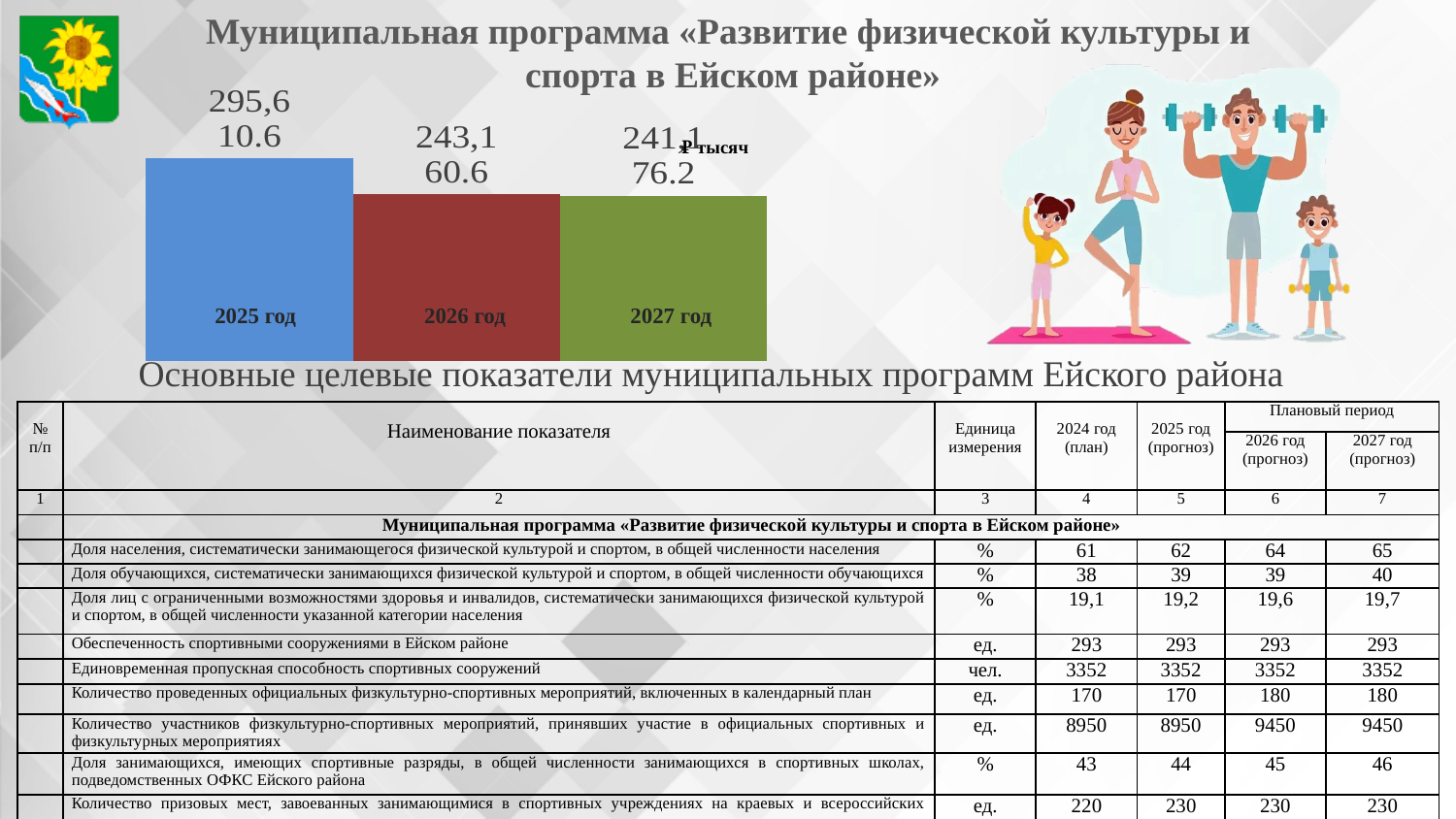
What unit label is printed on the chart? ₽ тысяч What kind of chart is shown at the top left of the slide? bar chart Do the bar values rise or fall from 2025 год to 2027 год? fall Which year has the tallest bar in the chart? 2025 год Which bar is taller, 2025 год or 2027 год? 2025 год Which bar is taller, 2025 год or 2026 год? 2025 год How many bars (years) does the chart show? 3 What colour is the bar for 2025 год? blue